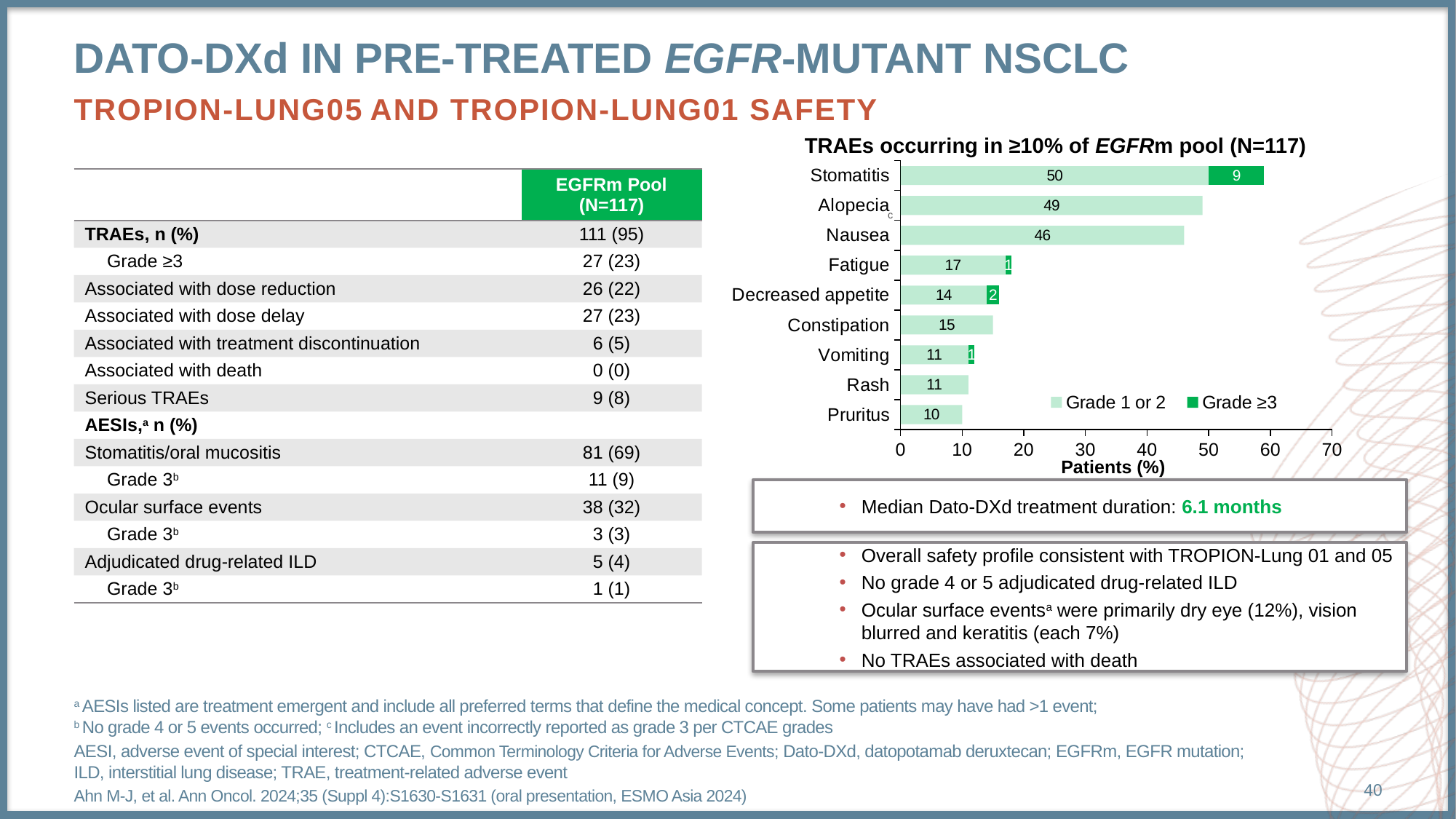
What is the Grade ≥3 value for Stomatitis? 9 What is the Grade 1 or 2 value for Stomatitis? 50 What is the Grade ≥3 value for Decreased appetite? 2 What type of chart is shown on the slide? Stacked bar chart Which has a larger Grade 1 or 2 value, Constipation or Decreased appetite? Constipation What is the Grade 1 or 2 value for Nausea? 46 Which TRAE has the lowest Grade 1 or 2 value? Pruritus How many series does the chart legend list? 2 Which TRAE has the highest Grade ≥3 value? Stomatitis What is the difference between the Grade 1 or 2 values for Alopecia and Nausea? 3 What is the total percentage of patients with Stomatitis (Grade 1 or 2 plus Grade ≥3)? 59 How many TRAE categories are shown in the chart? 9